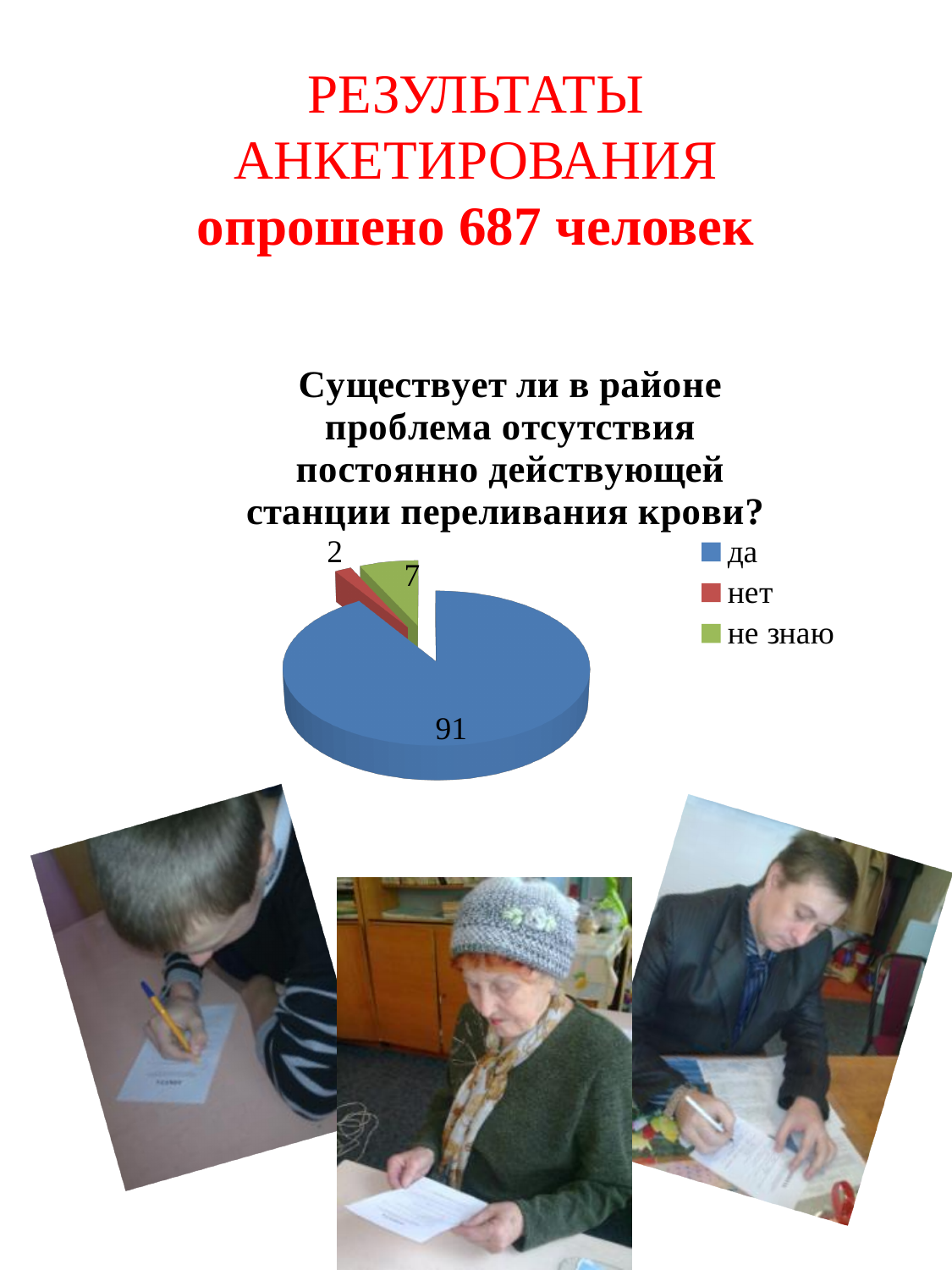
What is the difference between the values for "не знаю" and "нет"? 5 What type of chart is shown on the slide? pie chart What is the value for "да" in the pie chart? 91 What is the value for "не знаю" in the pie chart? 7 What share of the pie does the "да" slice represent? 91% Which is larger, the value for "нет" or the value for "не знаю"? не знаю What is the difference between the values for "да" and "не знаю"? 84 How many categories does the pie chart have? 3 Which answer has the smallest slice in the pie chart? нет What is the value for "нет" in the pie chart? 2 Which answer has the largest slice in the pie chart? да What colour is the "не знаю" slice in the pie chart? green